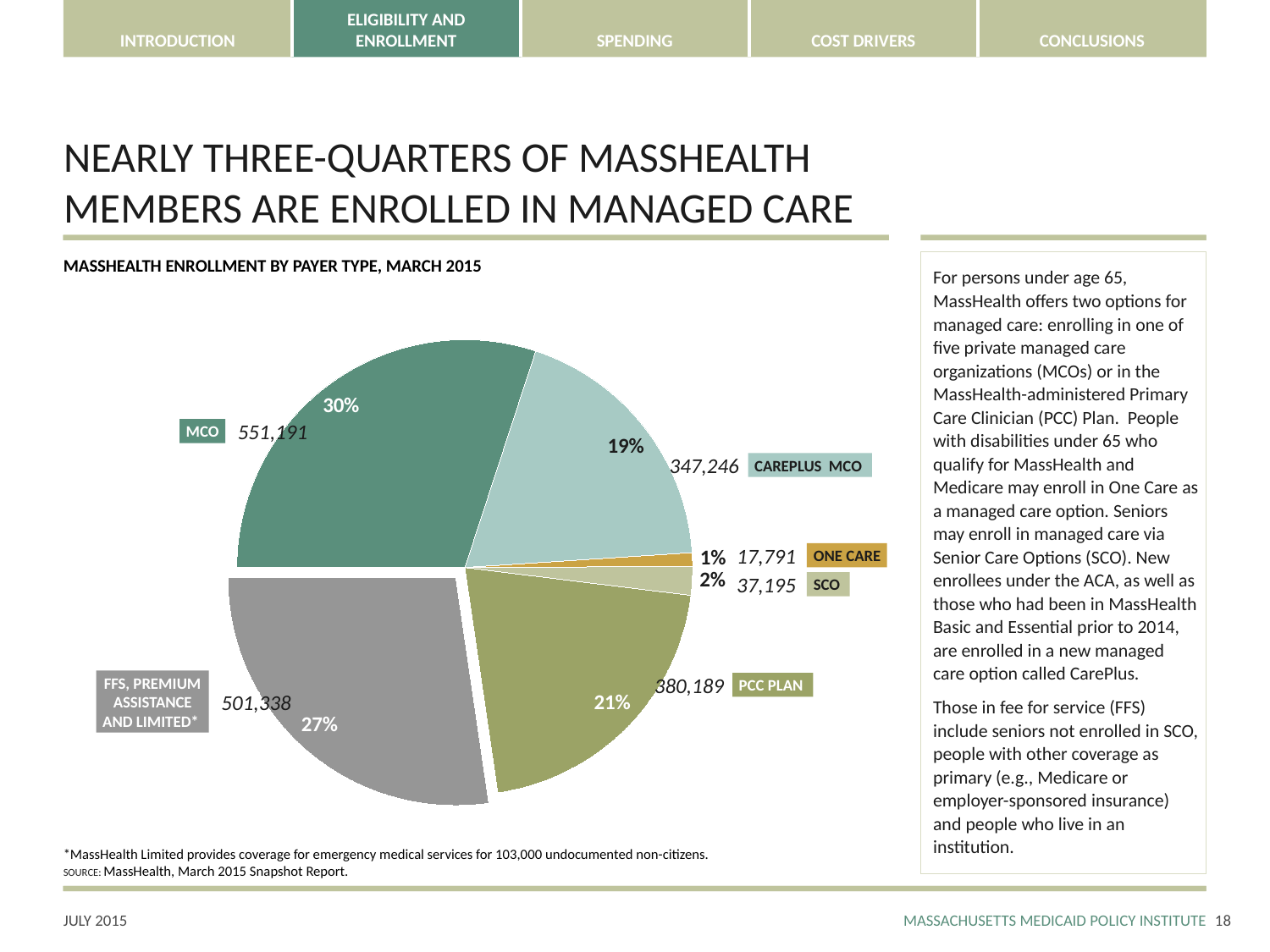
Which payer type has the smallest enrollment? One Care What type of chart is shown on the slide? Pie chart What is the enrollment value for One Care? 17,791 What is the difference in enrollment between MCO and FFS, Premium Assistance and Limited? 49,853 How many payer types (slices) are shown in the pie chart? 6 What share of the pie does FFS, Premium Assistance and Limited represent? 27% What share of the pie does CarePlus MCO represent? 19% Which has higher enrollment, PCC Plan or CarePlus MCO? PCC Plan What is the title of the chart? MassHealth Enrollment by Payer Type, March 2015 What is the enrollment value for MCO? 551,191 Which payer type has the largest enrollment? MCO What is the enrollment value for PCC Plan? 380,189